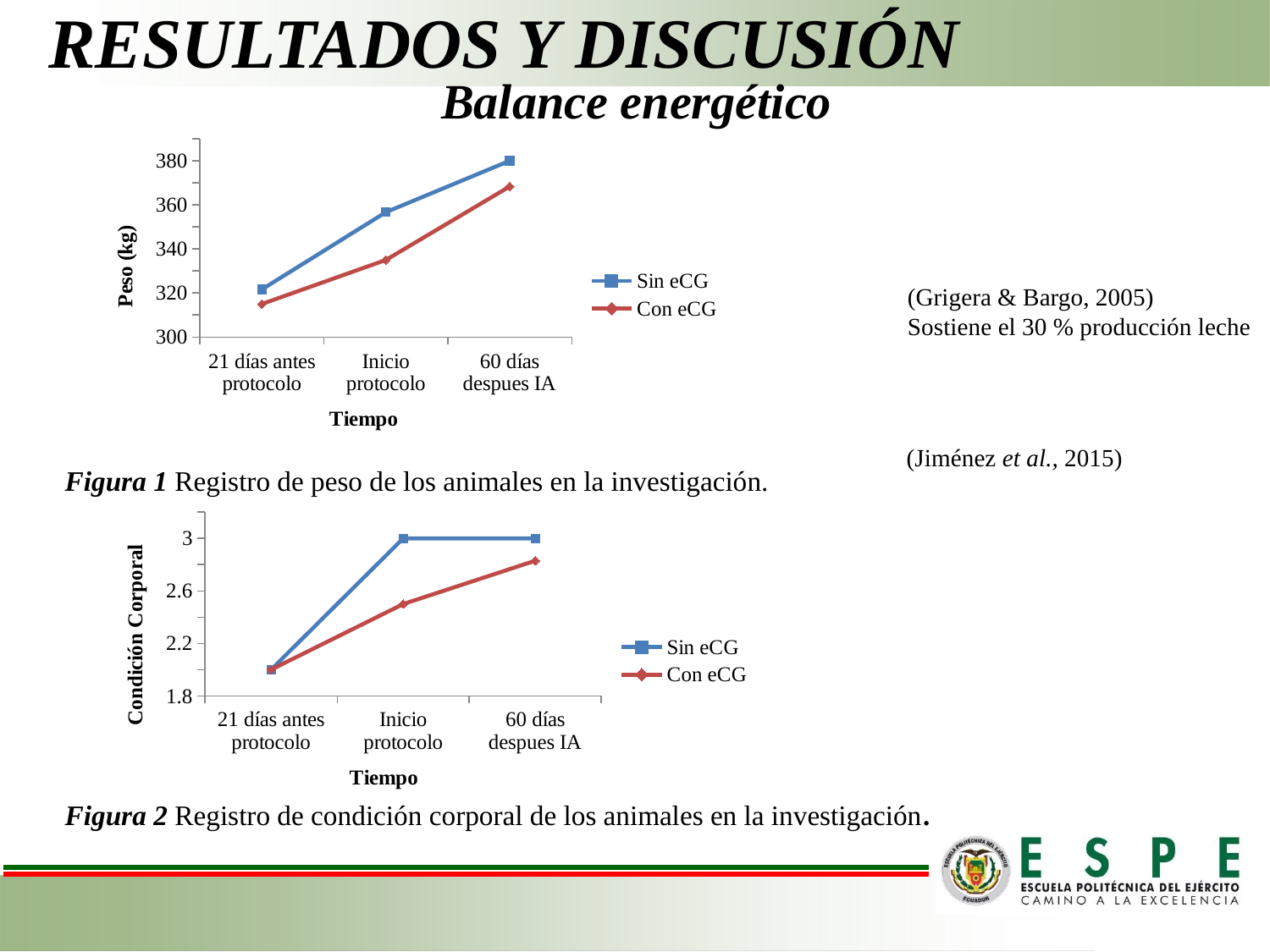
How many time points are plotted on the x axis of Figura 1? 3 What kind of chart is Figura 1 (Registro de peso)? line chart In Figura 2, is the Condición Corporal value for Con eCG at 60 días despues IA greater or less than 2.6? greater What is the y-axis label of Figura 2? Condición Corporal In Figura 2, which series has the higher Condición Corporal at Inicio protocolo, Sin eCG or Con eCG? Sin eCG In Figura 1, does the Peso for Con eCG rise or fall from 21 días antes protocolo to 60 días despues IA? rise In Figura 1, is the Peso value for Con eCG at Inicio protocolo greater or less than 340? less In Figura 1, which series has the higher Peso at 60 días despues IA, Sin eCG or Con eCG? Sin eCG How many series does the legend of Figura 1 list? 2 In Figura 1, is the Peso value for Sin eCG at Inicio protocolo greater or less than 340? greater In Figura 2, what is the Condición Corporal value for Sin eCG at Inicio protocolo? 3 In Figura 1, what is the Peso (kg) value for Sin eCG at 60 días despues IA? 380